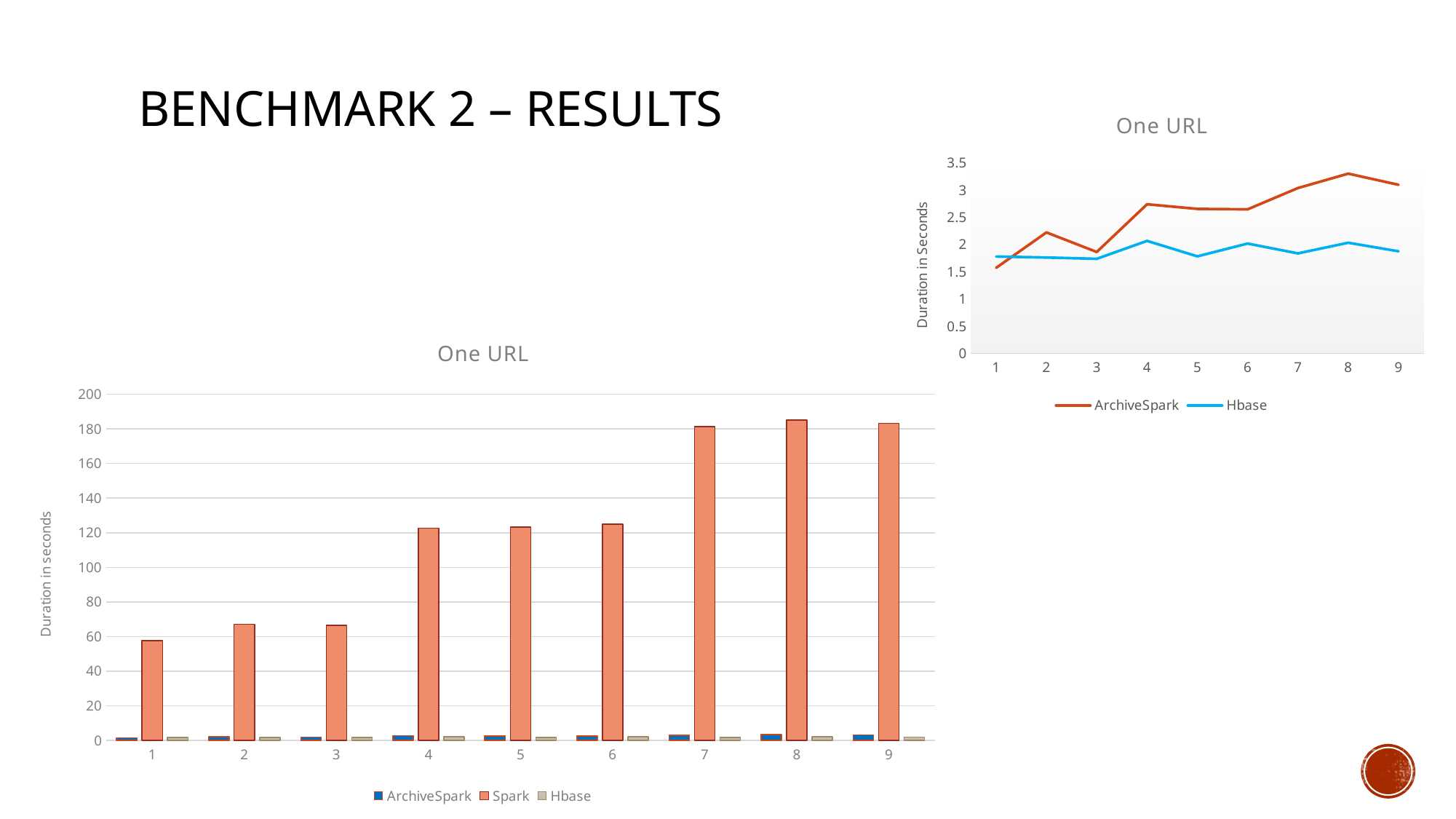
In the bar chart on the left, how many categories are shown on the x axis? 9 In the bar chart on the left, which series has the tallest bars in every category? Spark In the line chart on the top right, which category has the lowest ArchiveSpark value? 1 In the bar chart on the left, which category has the lowest Spark value? 1 In the line chart on the top right, which category has the highest ArchiveSpark value? 8 What kind of chart is the chart on the left of the slide? bar chart In the bar chart on the left, is the Spark value for category 7 greater or less than 160? greater In the line chart on the top right, is the ArchiveSpark value for category 8 greater or less than 3? greater In the bar chart on the left, is the Spark value for category 4 greater or less than 100? greater What kind of chart is the chart in the top right of the slide? line chart In the bar chart on the left, how many series does the legend list? 3 In the line chart on the top right, how many series does the legend list? 2